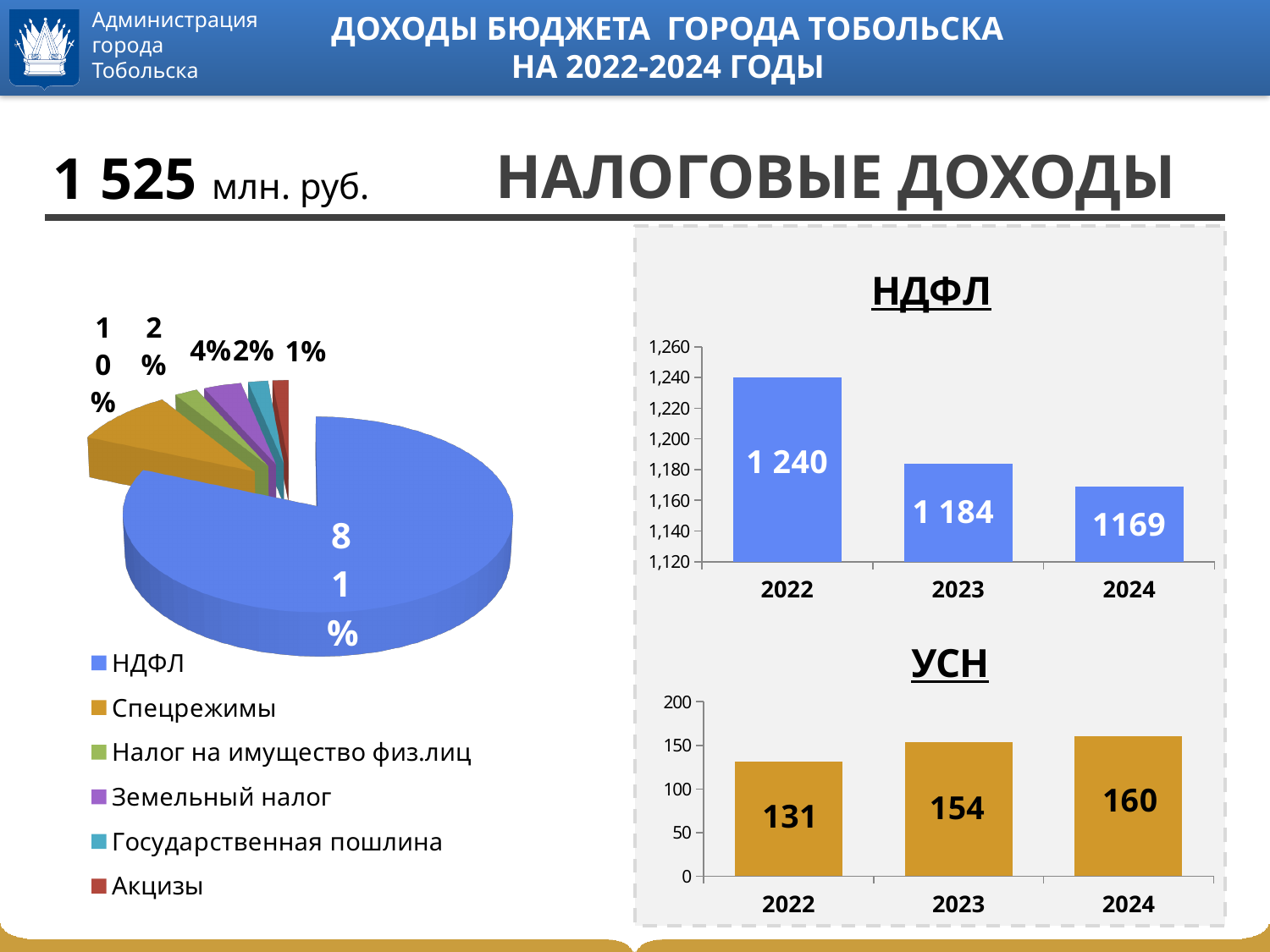
On the НДФЛ chart, what is the value for 2024? 1169 What kind of chart is the УСН chart? bar chart On the НДФЛ chart, what is the difference between the 2022 and 2023 values? 56 On the НДФЛ chart, which year has the lowest value? 2024 How many categories does the legend of the pie chart list? 6 On the УСН chart, what is the value for 2023? 154 On the УСН chart, which year has the highest value? 2024 On the УСН chart, do the values rise or fall from 2022 to 2024? rise On the НДФЛ chart, what is the value for 2022? 1 240 On the pie chart, what share does НДФЛ have? 81% On the НДФЛ chart, do the values rise or fall from 2022 to 2024? fall On the УСН chart, what is the difference between the 2024 and 2022 values? 29